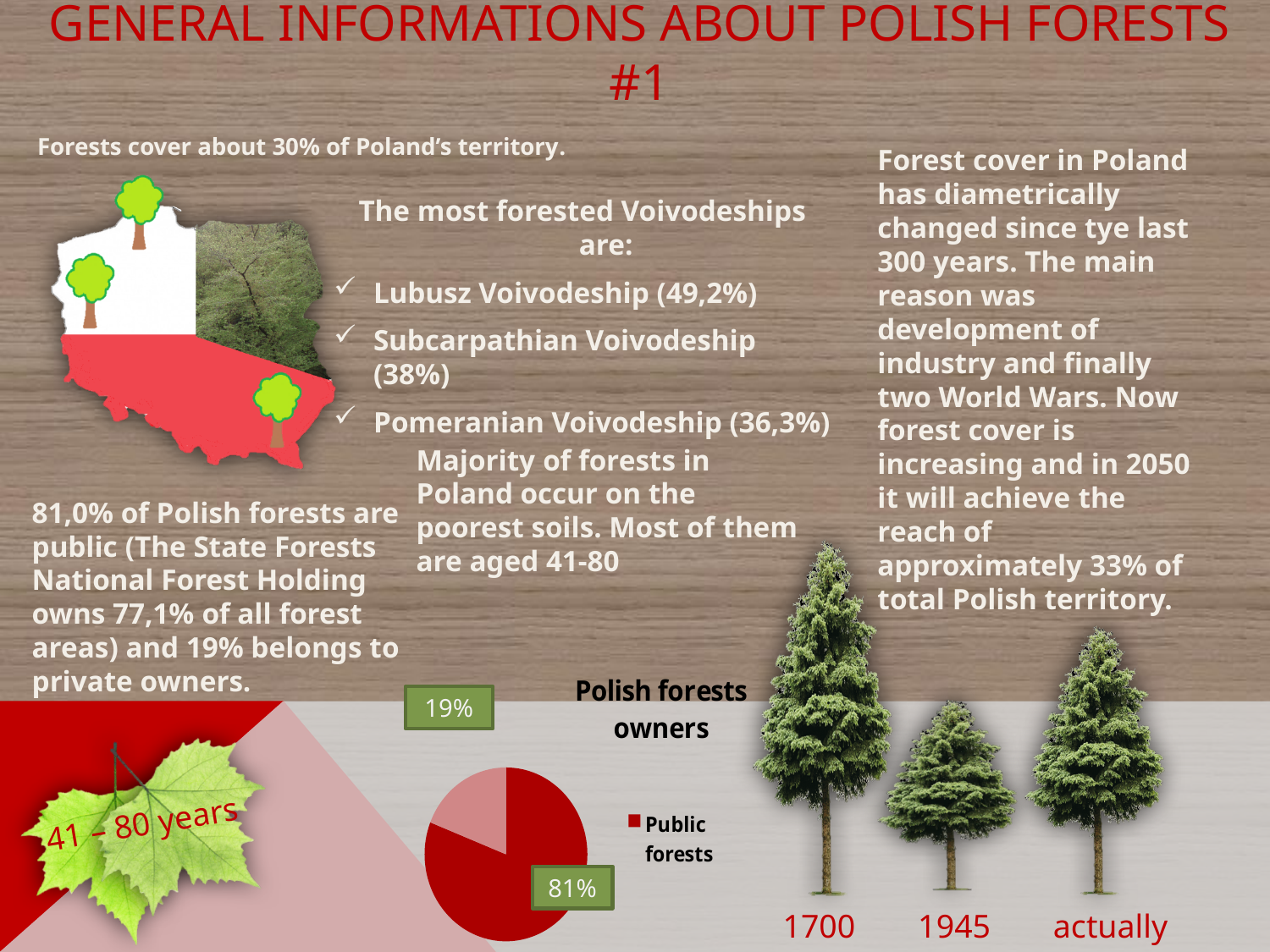
What is the title of the pie chart on the slide? Polish forests owners What do the two labelled slices of the "Polish forests owners" pie chart add up to? 100% Which slice is the largest in the "Polish forests owners" pie chart? Public forests How many slices does the "Polish forests owners" pie chart have? 2 In the "Polish forests owners" pie chart, is the share for Public forests greater or less than 50%? greater In the "Polish forests owners" pie chart, what is the difference between the 81% slice and the 19% slice? 62 percentage points In the "Polish forests owners" pie chart, what value is printed on the smaller slice? 19% In the "Polish forests owners" pie chart, what share is labelled for Public forests? 81% What colour is the Public forests slice in the "Polish forests owners" pie chart? dark red What kind of chart is the "Polish forests owners" chart? pie chart How many entries does the legend of the "Polish forests owners" pie chart list? 1 In the "Polish forests owners" pie chart, is the Public forests slice larger or smaller than the other slice? larger